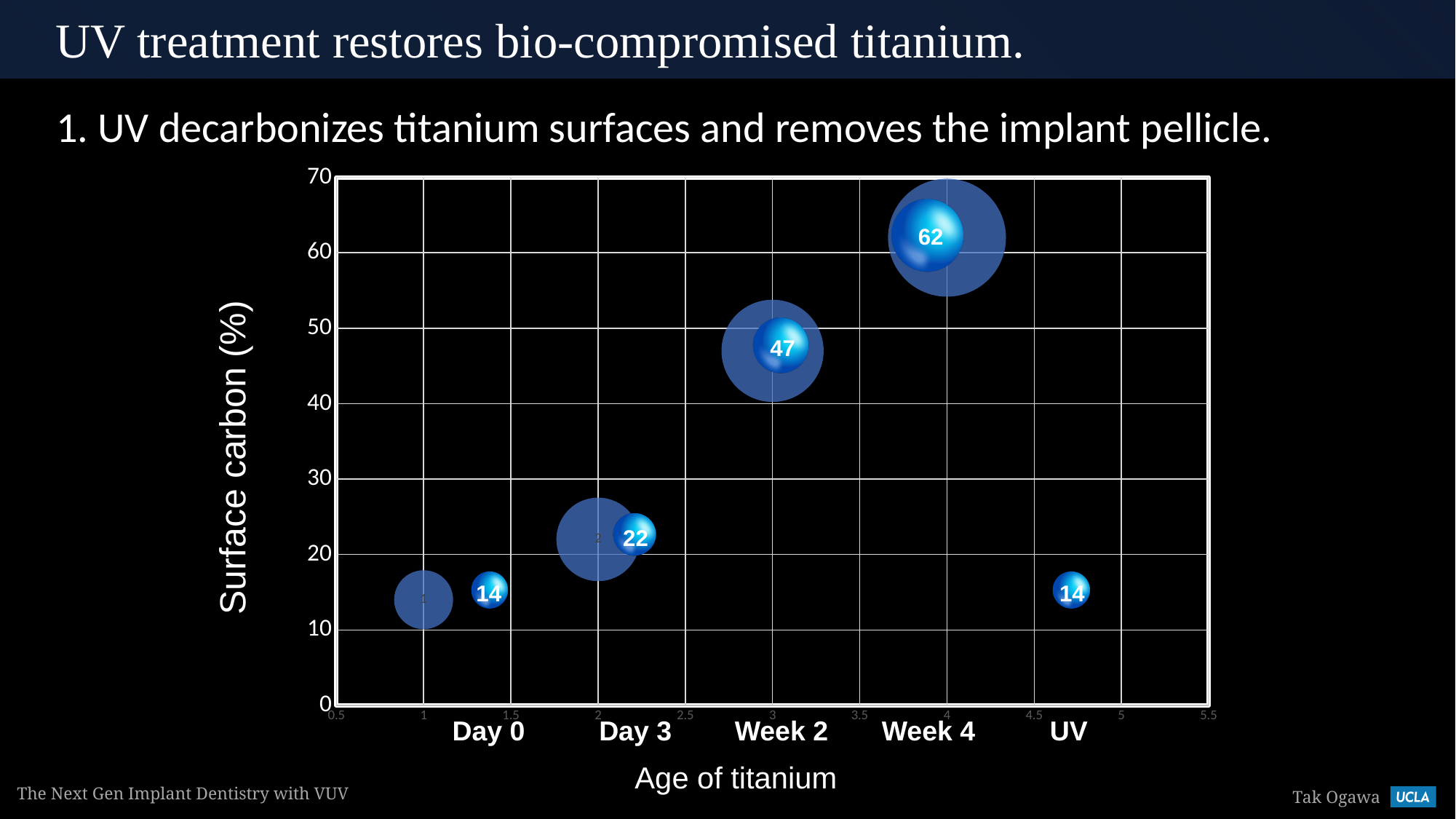
What is the title of the y axis? Surface carbon (%) What kind of chart is shown on the slide? Bubble chart Which age of titanium has the highest surface carbon? Week 4 What is the surface carbon value for Day 3? 22 What is the surface carbon value for Week 2? 47 How many age-of-titanium categories are plotted on the chart? 5 What is the difference in surface carbon between Week 4 and UV? 48 Which has a higher surface carbon value, Day 3 or Week 2? Week 2 Is the surface carbon value for Week 4 greater or less than 60? greater What is the surface carbon value for Week 4? 62 What is the difference in surface carbon between Week 4 and Week 2? 15 What is the surface carbon value for UV? 14